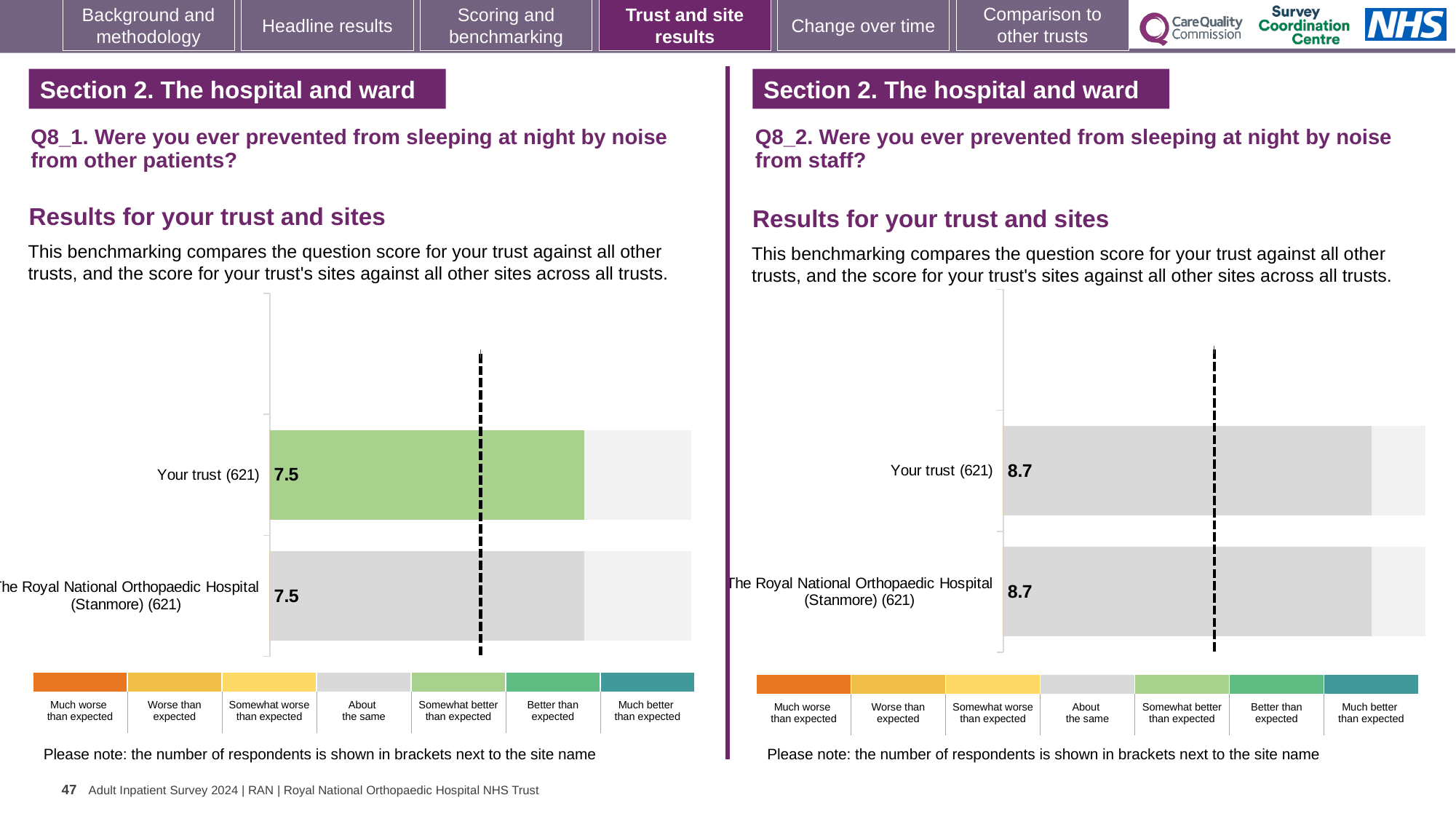
How many respondents are shown in brackets next to Your trust on the Q8_2 chart (right)? 621 On the Q8_2 chart (right), what is the difference between the score for Your trust and the score for The Royal National Orthopaedic Hospital (Stanmore)? 0 On the Q8_2 chart (right), what is the score for Your trust (621)? 8.7 On the Q8_2 chart (right), what is the score for The Royal National Orthopaedic Hospital (Stanmore) (621)? 8.7 What kind of chart is used on the Q8_1 chart (left)? Bar chart On the Q8_1 chart (left), what is the score for Your trust (621)? 7.5 On the Q8_1 chart (left), which benchmark category does the colour of the Your trust bar correspond to? Somewhat better than expected How many bars are plotted on the Q8_1 chart (left)? 2 How many bars are plotted on the Q8_2 chart (right)? 2 On the Q8_1 chart (left), what is the score for The Royal National Orthopaedic Hospital (Stanmore) (621)? 7.5 On the Q8_2 chart (right), which benchmark category does the colour of the Your trust bar correspond to? About the same On the Q8_1 chart (left), what is the difference between the score for Your trust and the score for The Royal National Orthopaedic Hospital (Stanmore)? 0